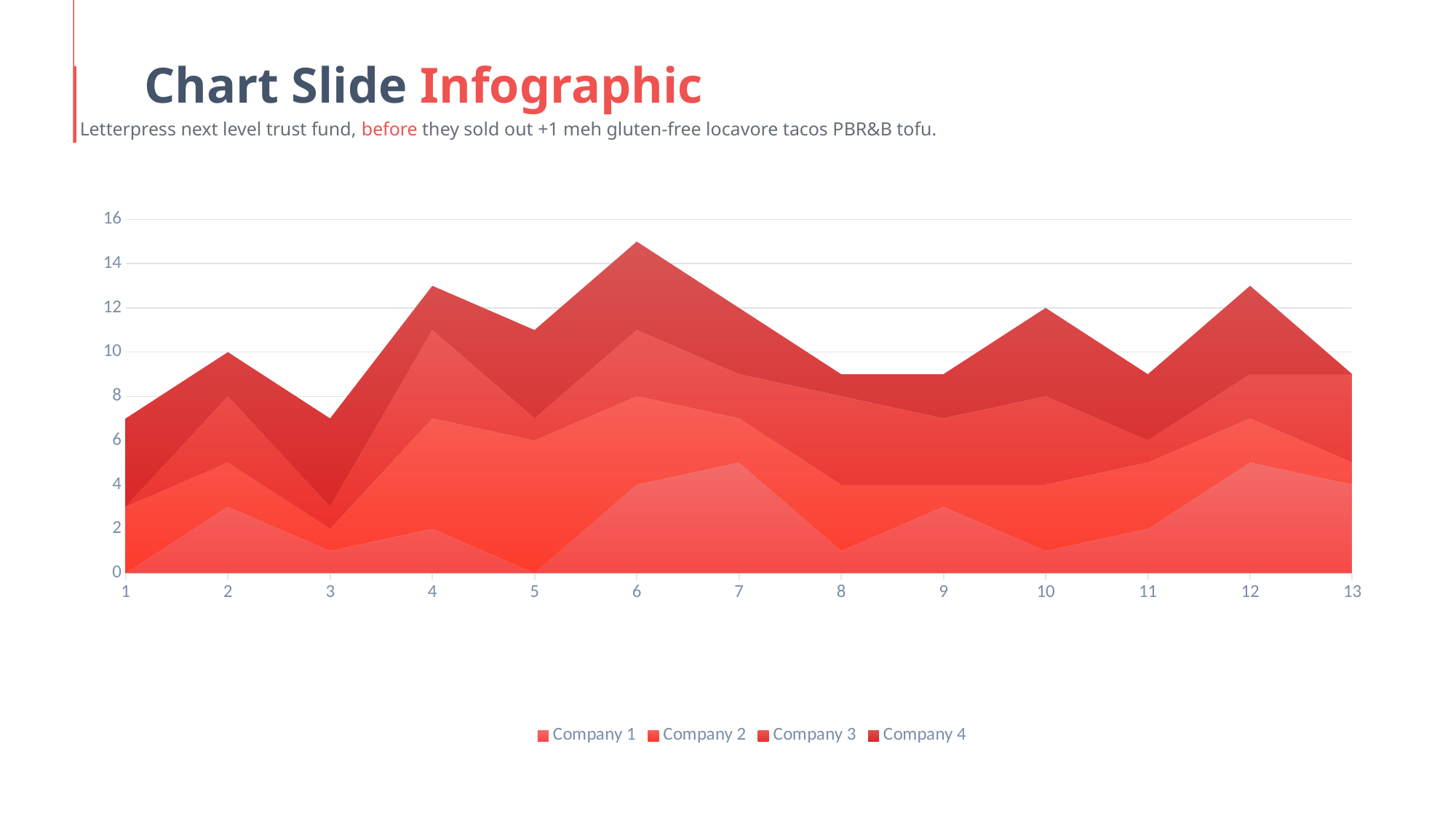
Is the value for Company 1 at x = 8 greater or less than 2? less What is the title of the slide? Chart Slide Infographic How many series does the legend list? 4 What are the four series named in the legend? Company 1, Company 2, Company 3, Company 4 Is the value for Company 1 at x = 7 greater or less than 4? greater Is the stacked total at x = 6 greater or less than 14? greater What kind of chart is shown on the slide? area chart What is the value for Company 1 at x = 1? 0 At which x value does the stacked total reach its highest point? 6 Is the stacked total larger at x = 4 or at x = 5? 4 How many points are plotted along the x axis? 13